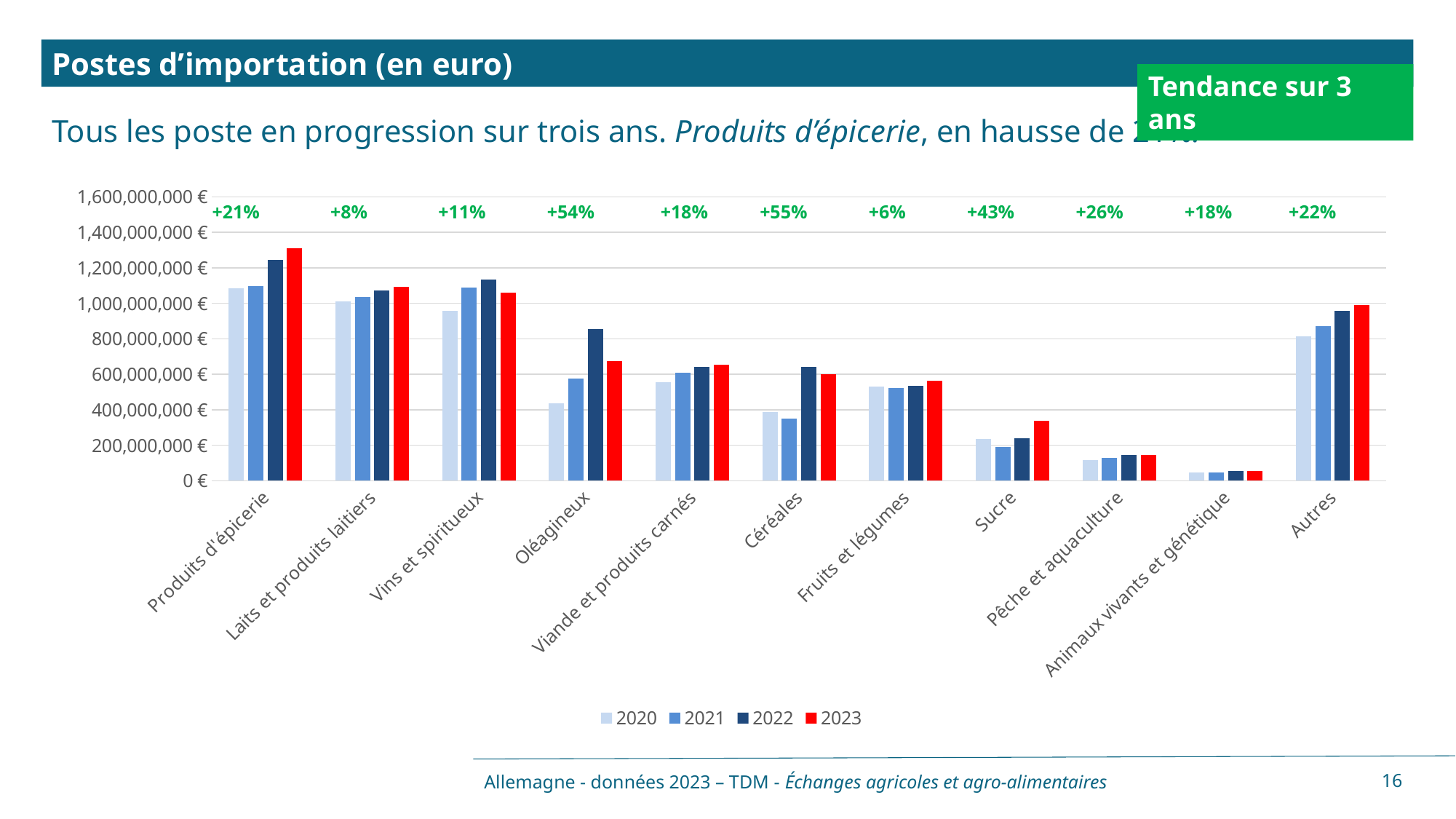
What three-year trend percentage is shown above Oléagineux? +54% Which category has the highest three-year trend percentage shown above the bars? Céréales Which category has the highest 2023 value? Produits d'épicerie What kind of chart is shown on the slide? bar chart What three-year trend percentage is shown above Sucre? +43% How many import categories are shown on the x axis of the chart? 11 Which colour represents the 2023 series in the legend? red Is the 2023 value for Produits d'épicerie greater or less than 1,200,000,000 €? greater Which category has the lowest three-year trend percentage shown above the bars? Fruits et légumes For Oléagineux, which year has the larger value, 2022 or 2023? 2022 How many series does the legend of the chart list? 4 Is the 2023 value for Sucre greater or less than 400,000,000 €? less